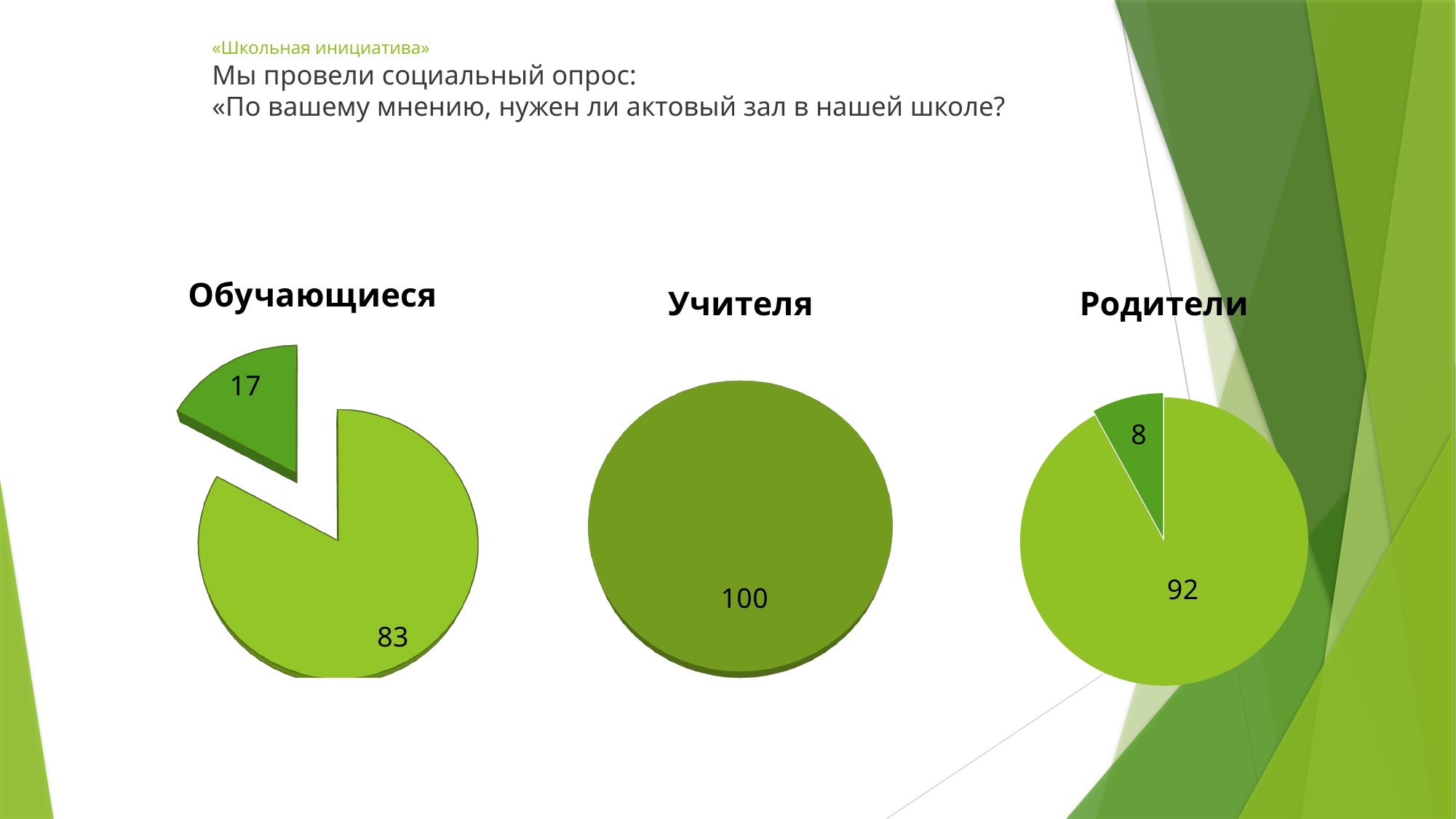
In the «Родители» chart, what value is printed on the larger slice? 92 How many slices does the «Учителя» pie chart have? 1 What kind of chart is used under the heading «Обучающиеся»? pie chart In the «Обучающиеся» chart, what value is printed on the smaller, pulled-out slice? 17 In the «Обучающиеся» chart, what is the difference between the two slice values, 83 and 17? 66 In the «Родители» chart, what value is printed on the smaller slice? 8 In the «Родители» chart, what is the difference between the two slice values, 92 and 8? 84 How many slices does the «Обучающиеся» pie chart have? 2 Which chart has the larger small slice: «Обучающиеся» (17) or «Родители» (8)? Обучающиеся How many charts are shown on the slide? 3 In the «Учителя» chart, what value is printed on the pie? 100 In the «Обучающиеся» chart, what value is printed on the larger slice? 83